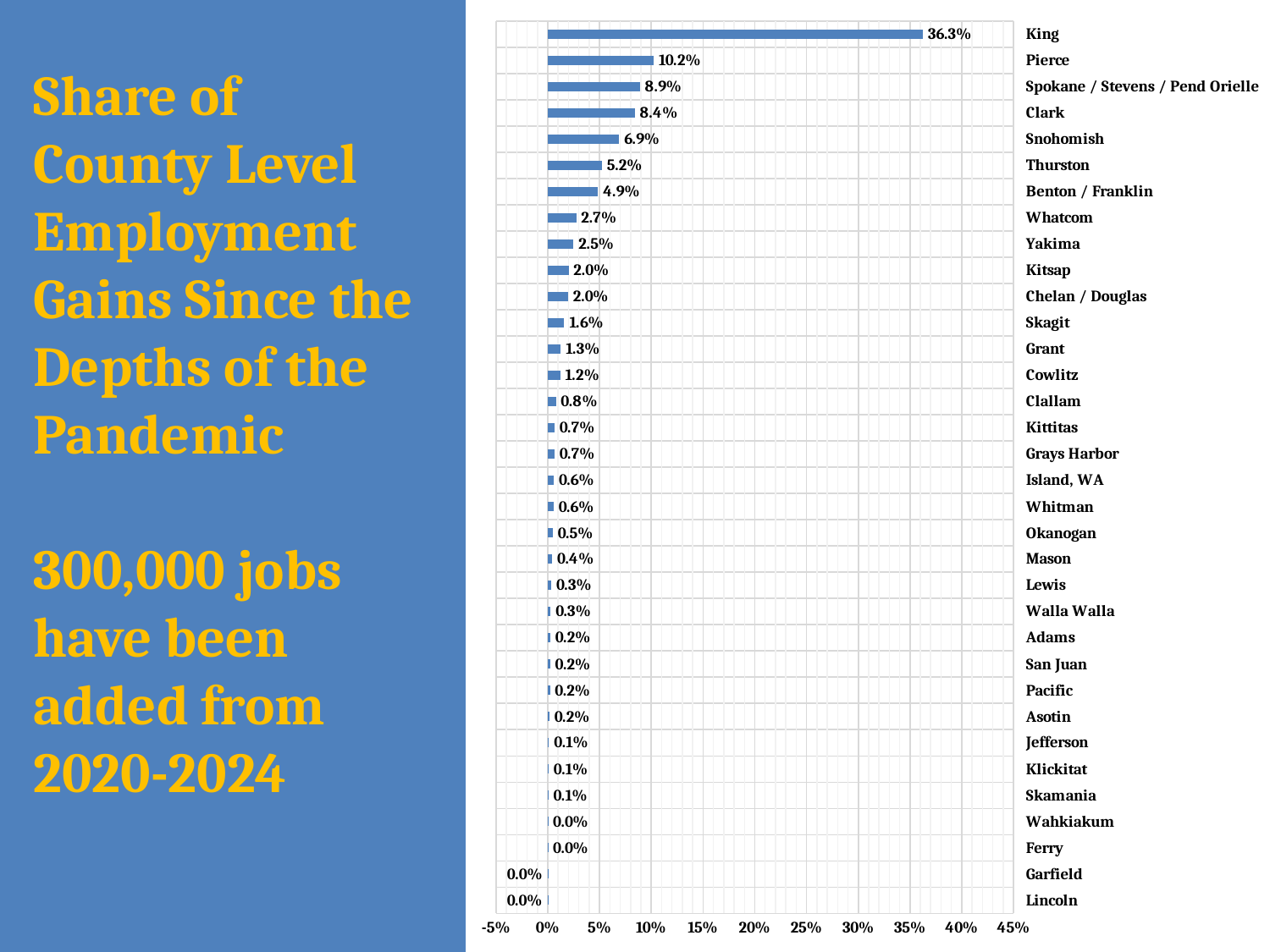
What is the value for Yakima? 2.5% What is the difference between the values for Pierce and Clark? 1.8% What is the difference between the values for King and Pierce? 26.1% What is the value for Benton / Franklin? 4.9% Which is larger, the value for Thurston or the value for Whatcom? Thurston What is the value for Skagit? 1.6% What is the value for Snohomish? 6.9% Which county has the highest share of employment gains? King How many counties or county groups are shown in the chart? 34 What kind of chart is shown on the slide? bar chart Is the value for King greater or less than 35%? greater What is the value for King? 36.3%